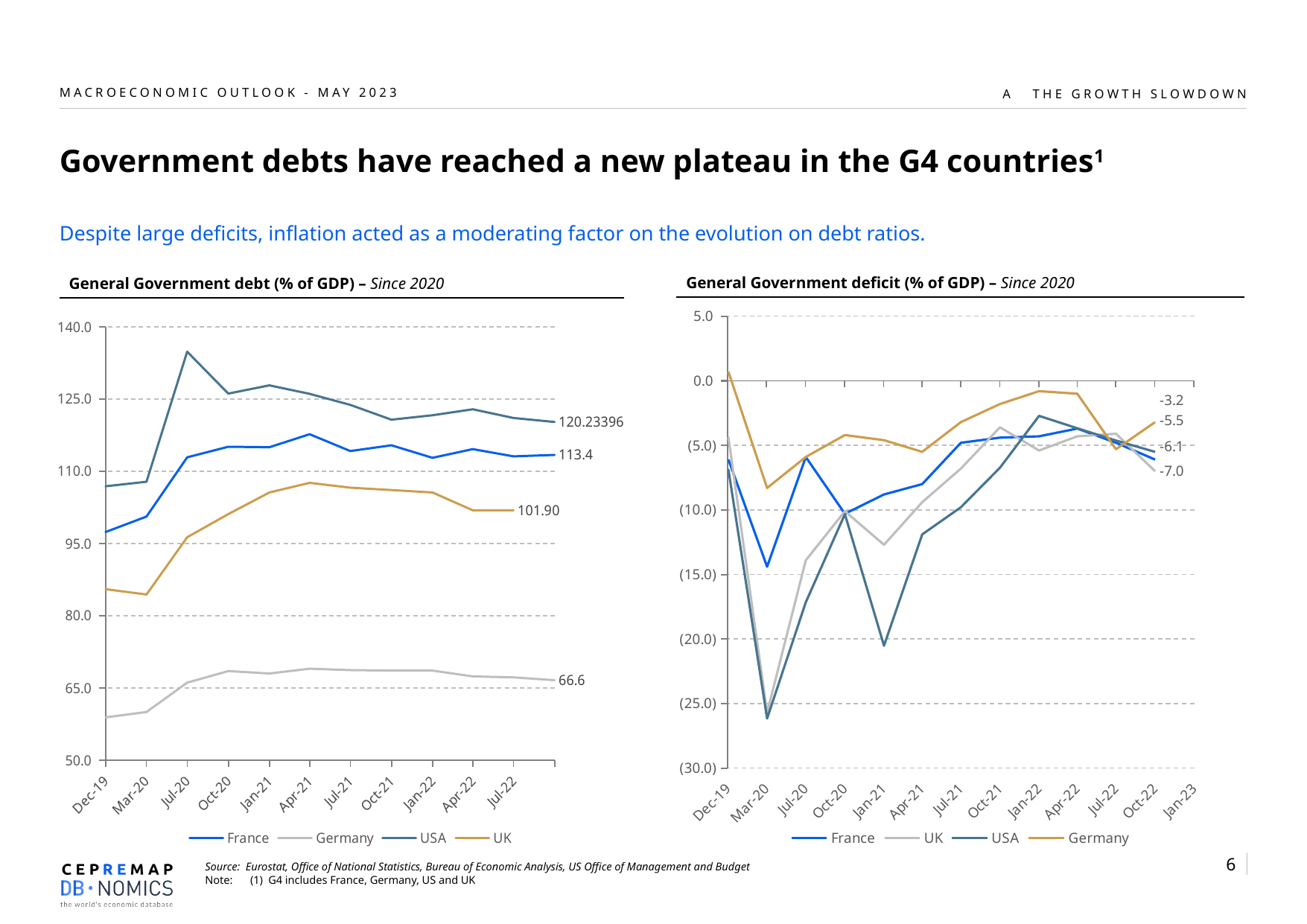
In the left chart, 'General Government debt (% of GDP)', what is the latest labelled value for Germany? 66.6 In the left chart, 'General Government debt (% of GDP)', which country has the lowest debt ratio at the end of the series? Germany In the right chart, 'General Government deficit (% of GDP)', is the value for the USA in Mar-20 greater or less than -20.0? less In the left chart, 'General Government debt (% of GDP)', what is the latest labelled value for France? 113.4 How many series does the legend of the left chart, 'General Government debt (% of GDP)', list? 4 In the right chart, 'General Government deficit (% of GDP)', what is the latest labelled value for Germany? -3.2 In the left chart, 'General Government debt (% of GDP)', what is the latest labelled value for the USA? 120.23396 In the left chart, 'General Government debt (% of GDP)', is the value for Germany in Dec-19 greater or less than 65.0? less What kind of chart is the 'General Government debt (% of GDP)' chart on the left? Line chart In the left chart, 'General Government debt (% of GDP)', does the UK line rise or fall between Dec-19 and Apr-21? rise In the left chart, 'General Government debt (% of GDP)', what is the latest labelled value for the UK? 101.90 In the left chart, 'General Government debt (% of GDP)', what is the difference between the latest labelled values for France and Germany? 46.8